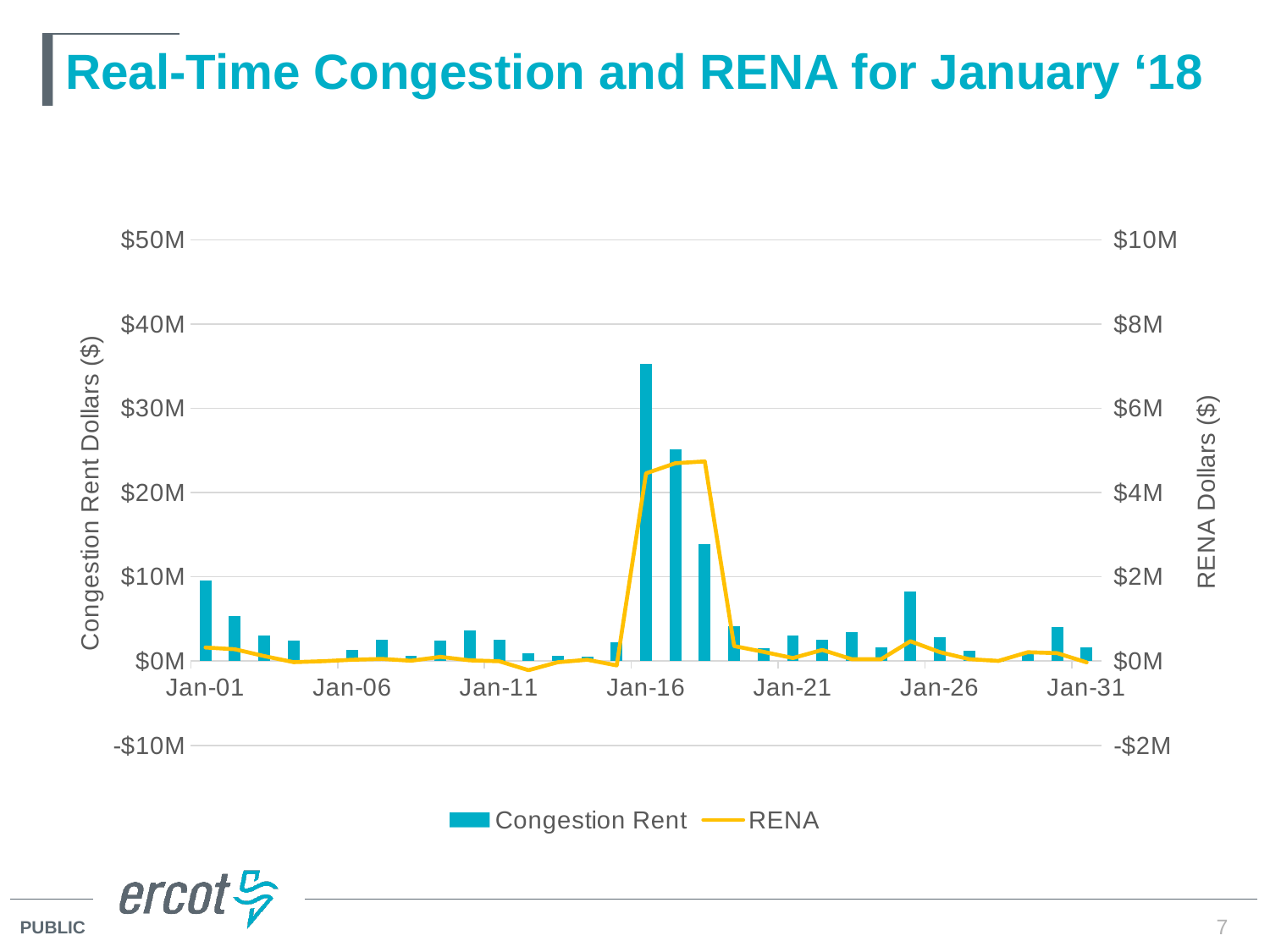
How many date labels are shown on the x axis? 7 On which date is the Congestion Rent bar highest? Jan-16 Is the Congestion Rent value for Jan-16 greater or less than $30M? greater Is the RENA value for Jan-17 greater or less than $4M? greater How many series does the legend list? 2 What is the title of the chart? Real-Time Congestion and RENA for January '18 Is the Congestion Rent value for Jan-18 greater or less than $20M? less Which has the larger Congestion Rent value, Jan-17 or Jan-18? Jan-17 What type of chart is shown on the slide? A combined bar and line chart Which has the larger Congestion Rent value, Jan-16 or Jan-17? Jan-16 Which two series are listed in the legend? Congestion Rent and RENA